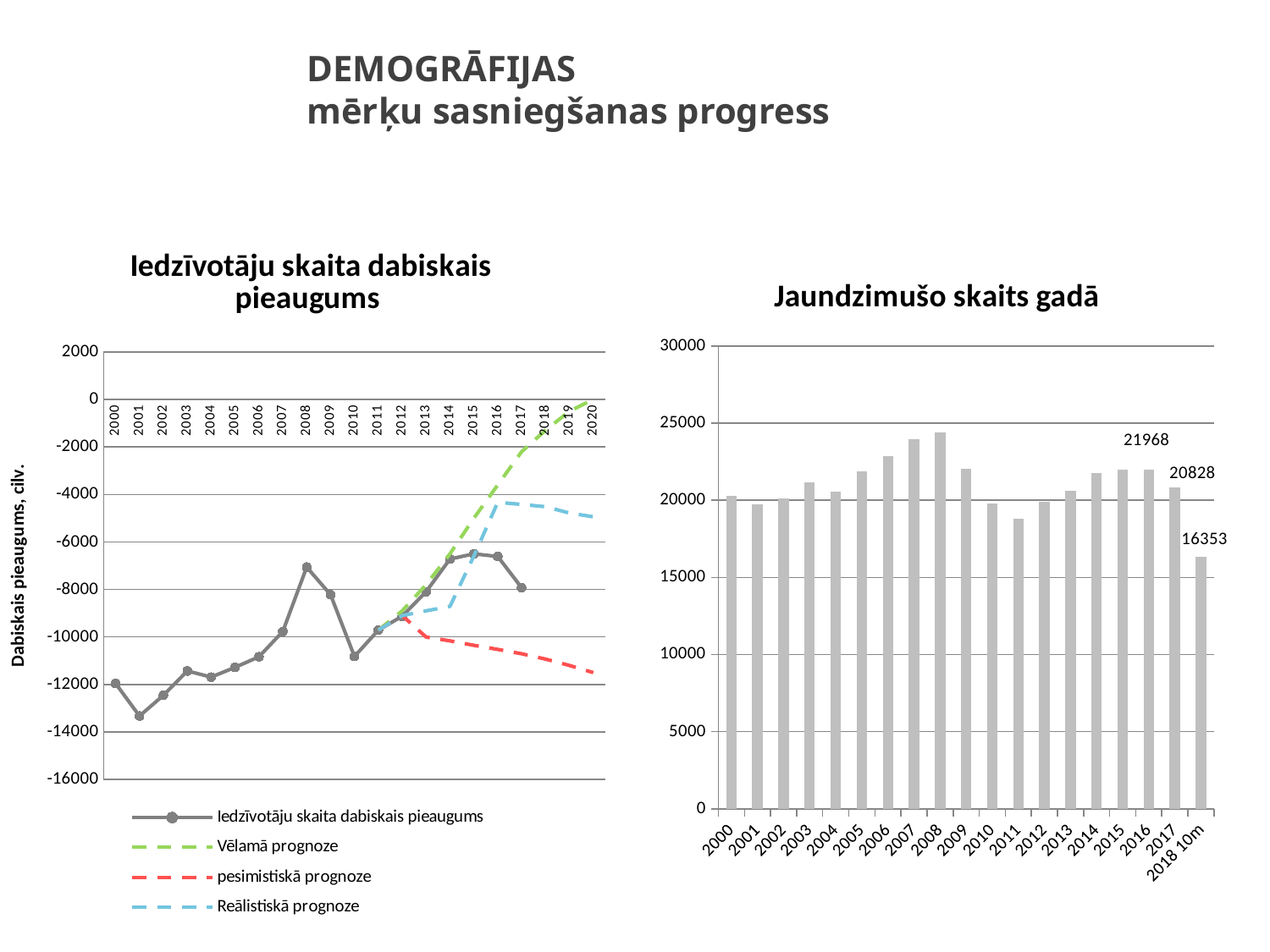
How many bars are shown in the 'Jaundzimušo skaits gadā' chart? 19 In the 'Jaundzimušo skaits gadā' chart, what is the value for 2017? 20828 What kind of chart is 'Jaundzimušo skaits gadā'? bar chart How many series does the legend of the 'Iedzīvotāju skaita dabiskais pieaugums' chart list? 4 In the 'Jaundzimušo skaits gadā' chart, which category has the lowest bar? 2018 10m In the 'Jaundzimušo skaits gadā' chart, is the value for 2011 greater or less than 20000? less In the 'Iedzīvotāju skaita dabiskais pieaugums' chart, is the 2010 value of the 'Iedzīvotāju skaita dabiskais pieaugums' line greater or less than -10000? less In the 'Iedzīvotāju skaita dabiskais pieaugums' chart, which year has the lowest value on the 'Iedzīvotāju skaita dabiskais pieaugums' line? 2001 In the 'Jaundzimušo skaits gadā' chart, what is the value for 2018 10m? 16353 In the 'Jaundzimušo skaits gadā' chart, what is the difference between the 2017 value and the 2018 10m value? 4475 In the 'Jaundzimušo skaits gadā' chart, which year has the highest bar? 2008 In the 'Jaundzimušo skaits gadā' chart, what is the value for 2016? 21968